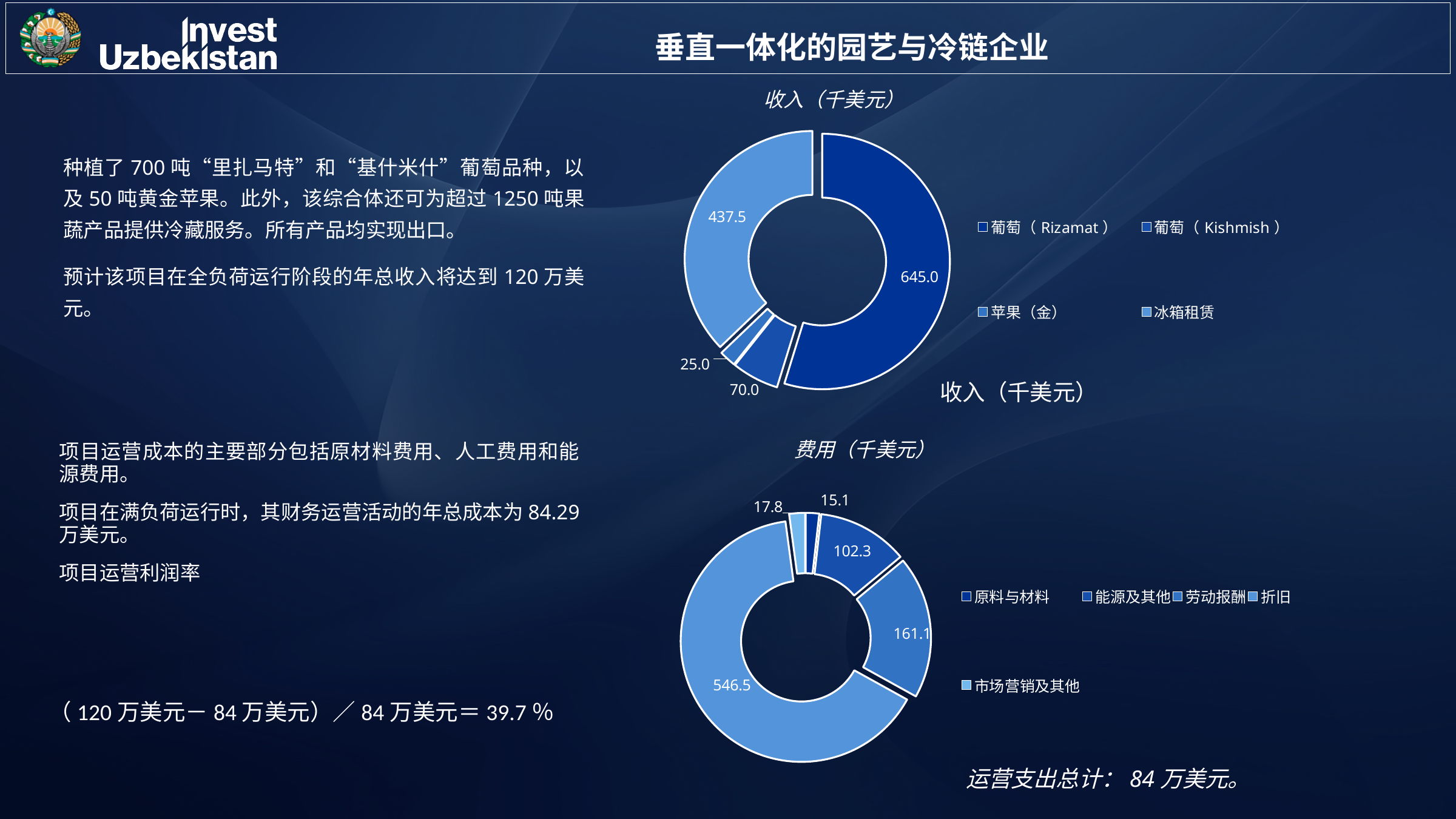
In the 收入（千美元） chart, which category has the smallest value? 苹果（金） In the 收入（千美元） chart, what is the difference between the values for 葡萄（Rizamat） and 冰箱租赁? 207.5 In the 费用（千美元） chart, what is the value for 劳动报酬? 161.1 In the 费用（千美元） chart, what is the value for 能源及其他? 102.3 How many categories does the legend of the 费用（千美元） chart list? 5 In the 收入（千美元） chart, what is the value for 冰箱租赁? 437.5 In the 收入（千美元） chart, what is the value for 葡萄（Rizamat）? 645.0 What kind of chart is the 收入（千美元） chart? Doughnut chart In the 费用（千美元） chart, which is larger: 原料与材料 or 能源及其他? 能源及其他 In the 费用（千美元） chart, which category has the largest value? 折旧 In the 费用（千美元） chart, what is the difference between the values for 折旧 and 市场营销及其他? 528.7 In the 收入（千美元） chart, how many categories are shown? 4